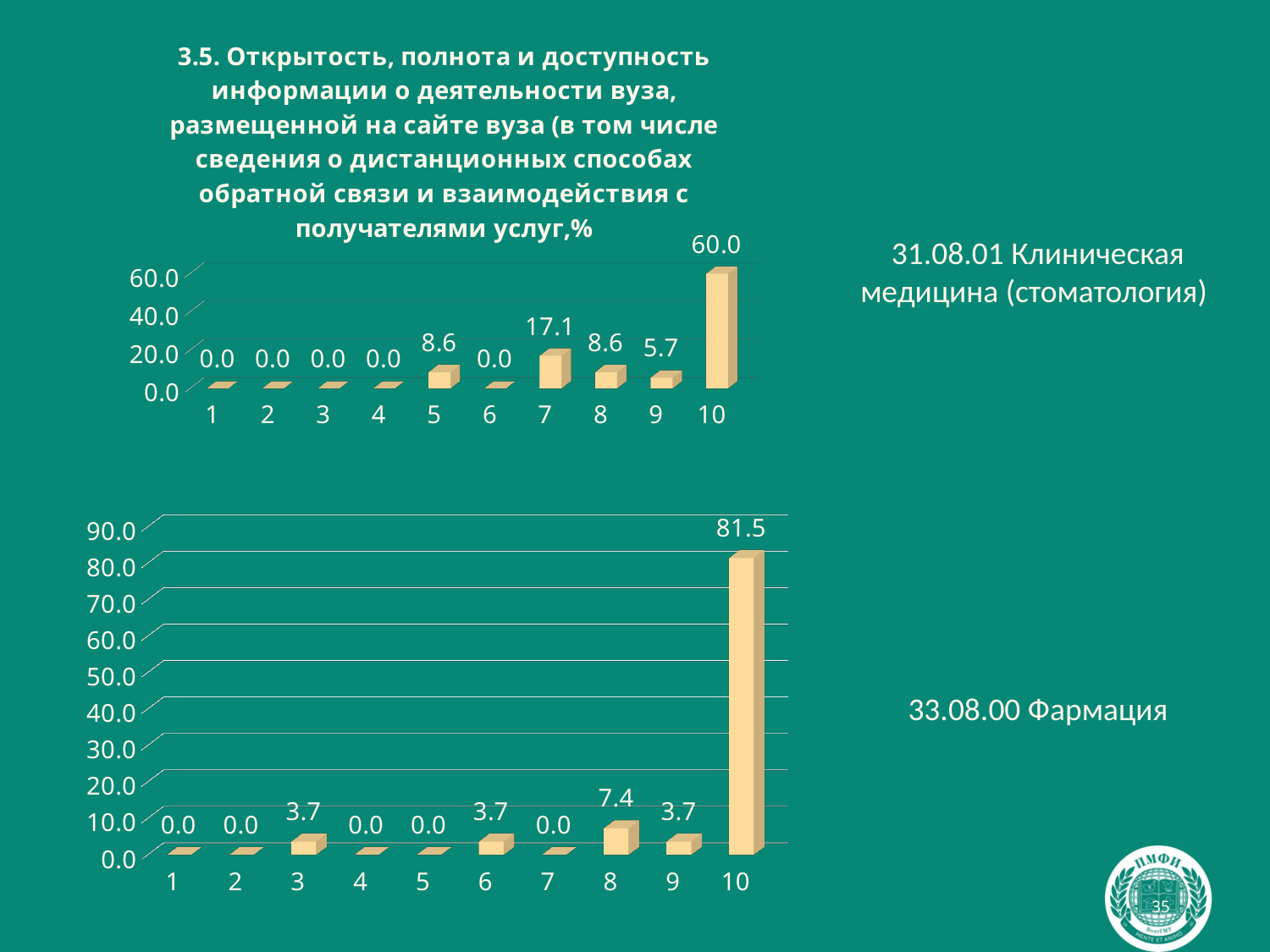
In the bottom chart (33.08.00 Фармация), which is larger, the value for category 8 or the value for category 9? category 8 In the top chart (31.08.01 Клиническая медицина), which category has the highest value? 10 In the top chart (31.08.01 Клиническая медицина), how many categories are shown on the x axis? 10 In the bottom chart (33.08.00 Фармация), what is the difference between the values for category 10 and category 8? 74.1 What kind of chart is the bottom chart (33.08.00 Фармация)? bar chart In the bottom chart (33.08.00 Фармация), is the value for category 10 greater or less than 80.0? greater In the bottom chart (33.08.00 Фармация), what is the value for category 8? 7.4 In the bottom chart (33.08.00 Фармация), what is the value for category 10? 81.5 In the bottom chart (33.08.00 Фармация), how many categories have a value of 0.0? 5 In the top chart (31.08.01 Клиническая медицина), what is the value for category 7? 17.1 In the top chart (31.08.01 Клиническая медицина), what is the value for category 10? 60.0 In the top chart (31.08.01 Клиническая медицина), what is the difference between the values for category 10 and category 7? 42.9